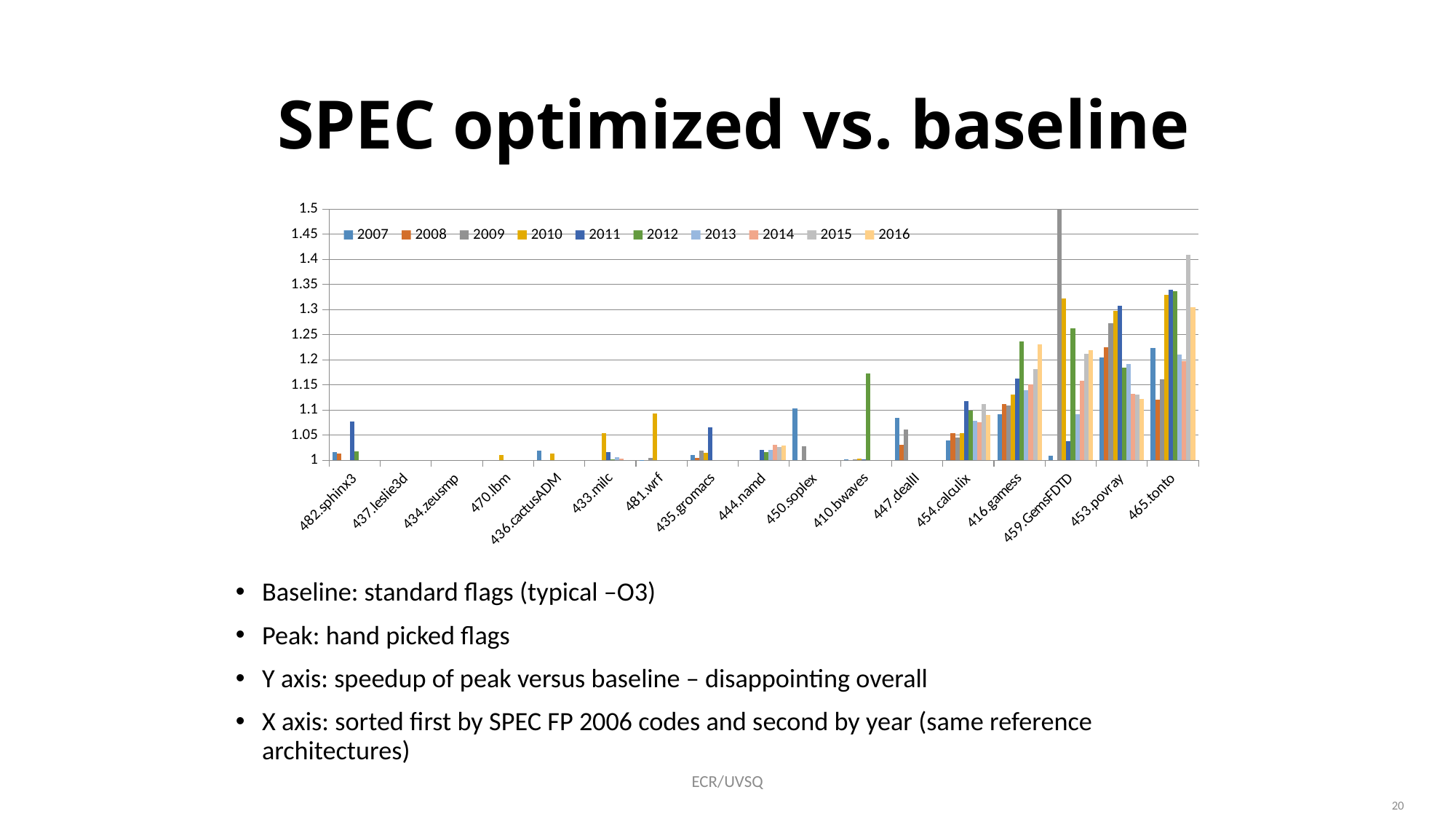
Is the 2010 value for 459.GemsFDTD greater or less than 1.3? greater Which series has the tallest bar for 459.GemsFDTD? 2009 Is the 2012 value for 416.gamess greater or less than 1.2? greater Which series has the tallest bar for 465.tonto? 2015 What is the highest value shown on the y axis? 1.5 What kind of chart is shown on the slide? bar chart Which series has the tallest bar for 410.bwaves? 2012 How many benchmark categories are shown along the x axis? 17 How many series does the chart legend list? 10 For 459.GemsFDTD, which is larger: the 2009 value or the 2010 value? 2009 Is the 2015 value for 465.tonto greater or less than 1.35? greater